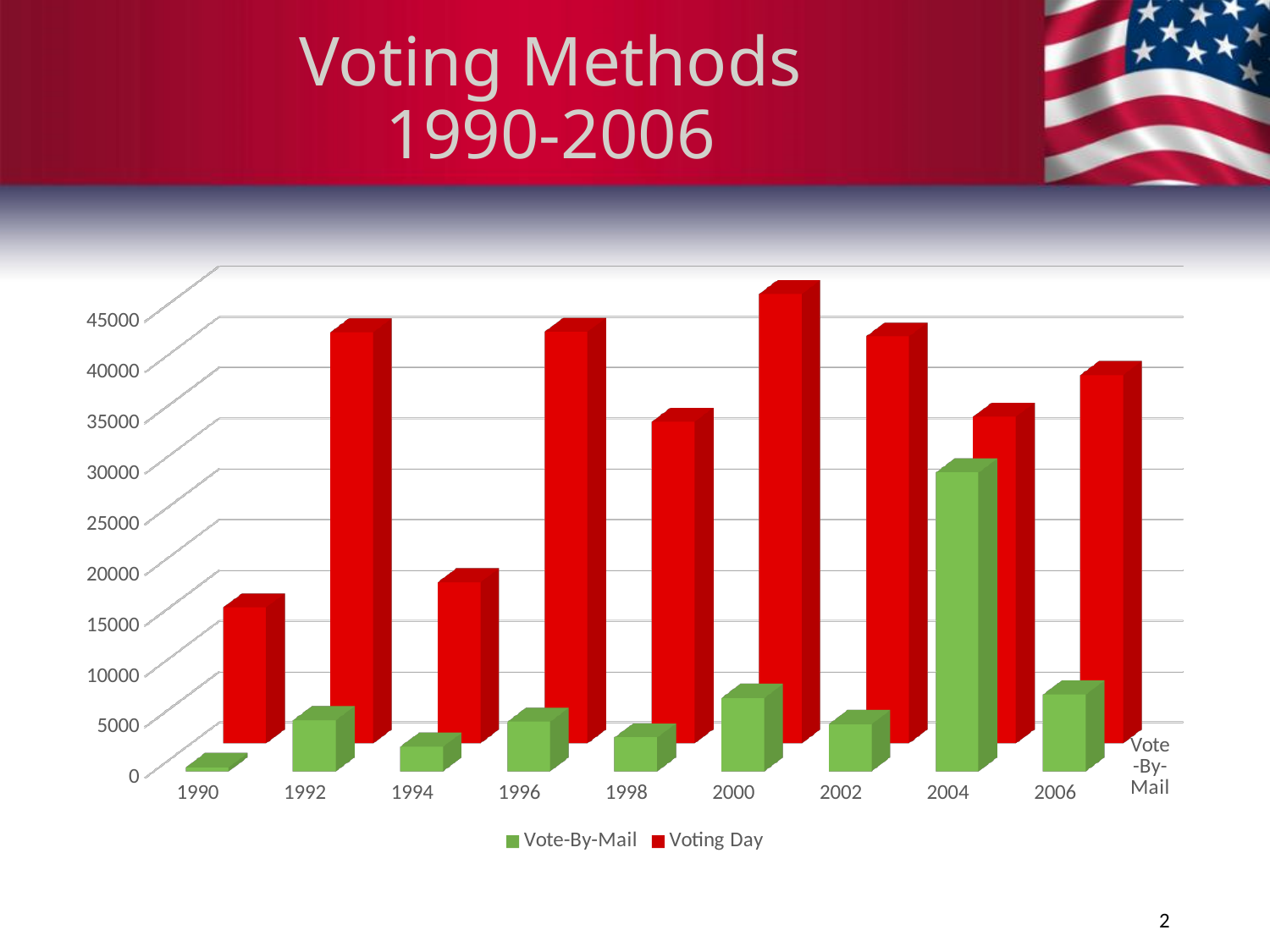
Is the Voting Day value for 1998 greater or less than 30000? greater What kind of chart is shown on the slide? bar chart How many years are shown along the x axis? 9 In which year is the Voting Day value highest? 2000 Is the Voting Day value for 2000 greater or less than 40000? greater Is the Voting Day value for 1990 greater or less than 20000? less In which year is the Vote-By-Mail value highest? 2004 How many series does the legend list? 2 In 2004, which is larger: Vote-By-Mail or Voting Day? Voting Day In which year is the Vote-By-Mail value lowest? 1990 Which colour represents the Vote-By-Mail series? green